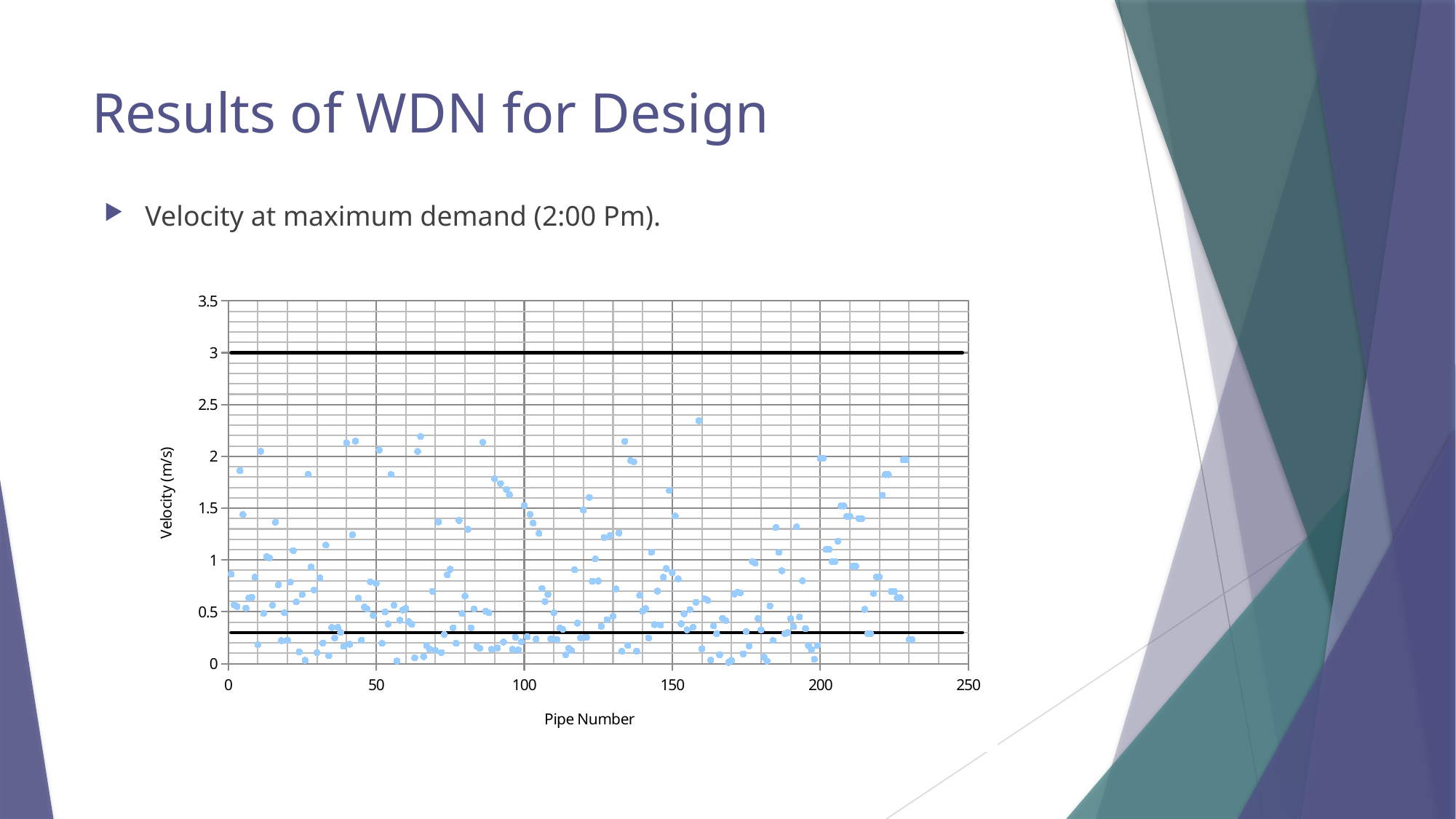
Is the lower horizontal black line drawn at a velocity greater or less than 0.5? less What is the maximum value shown on the horizontal axis? 250 Is the highest plotted velocity greater or less than 2? greater At what velocity value is the upper horizontal black line drawn? 3 How many horizontal black reference lines are drawn on the chart? 2 What is the maximum value shown on the vertical axis? 3.5 Is the highest plotted velocity greater or less than 2.5? less What is the label of the vertical axis of the chart? Velocity (m/s) What is the label of the horizontal axis of the chart? Pipe Number What kind of chart is shown on the slide? scatter chart